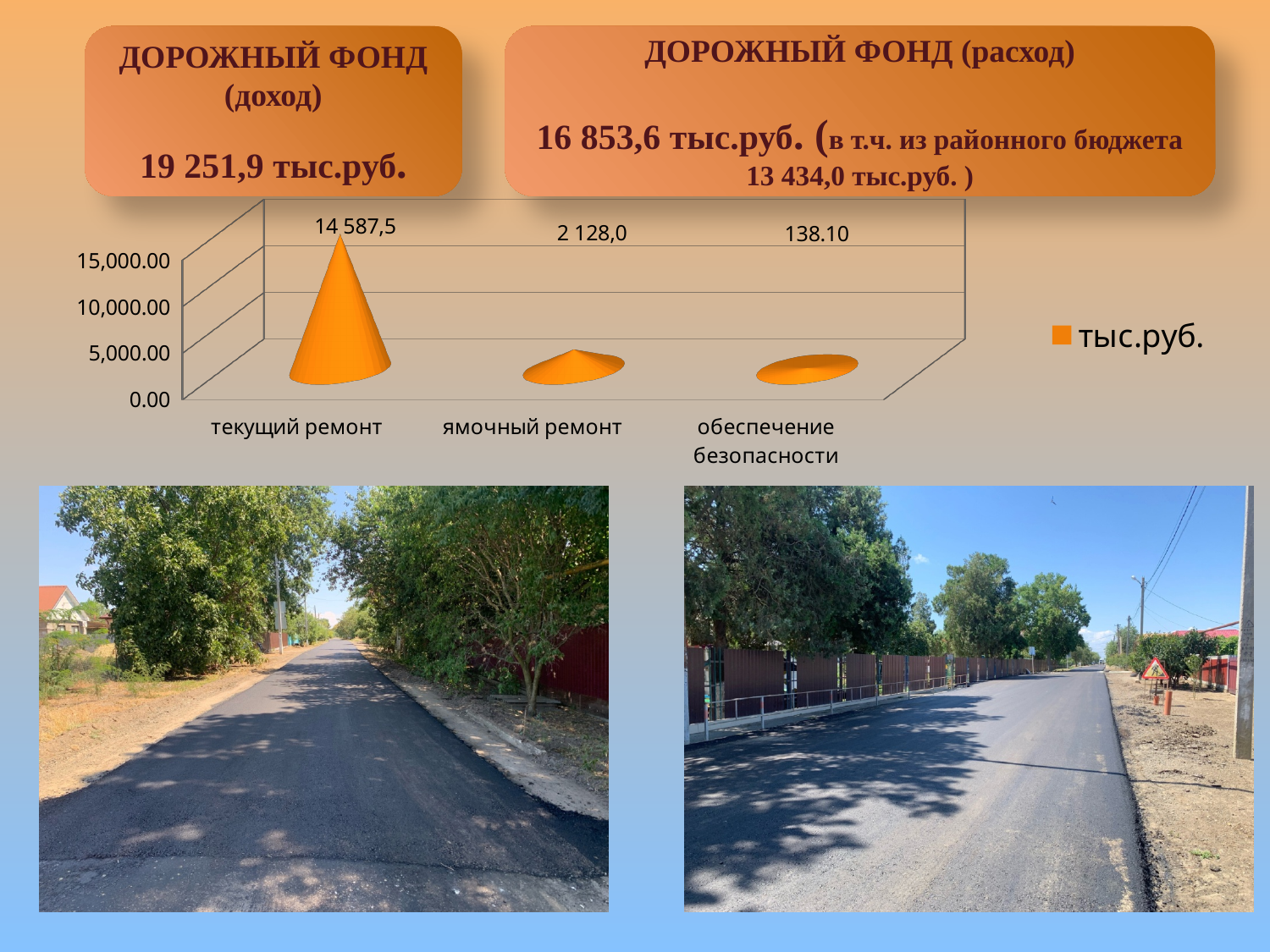
Which category has the lowest value? обеспечение безопасности Which is larger, the value for ямочный ремонт or the value for обеспечение безопасности? ямочный ремонт What is the value for текущий ремонт? 14 587,5 What is the legend entry of the chart? тыс.руб. How many categories are shown on the chart? 3 Which category has the highest value? текущий ремонт Is the value for текущий ремонт greater or less than 10,000.00? greater What is the value for ямочный ремонт? 2 128,0 Is the value for ямочный ремонт greater or less than 5,000.00? less What is the value for обеспечение безопасности? 138.10 How many series does the legend list? 1 What is the difference between the values for текущий ремонт and ямочный ремонт? 12 459,5